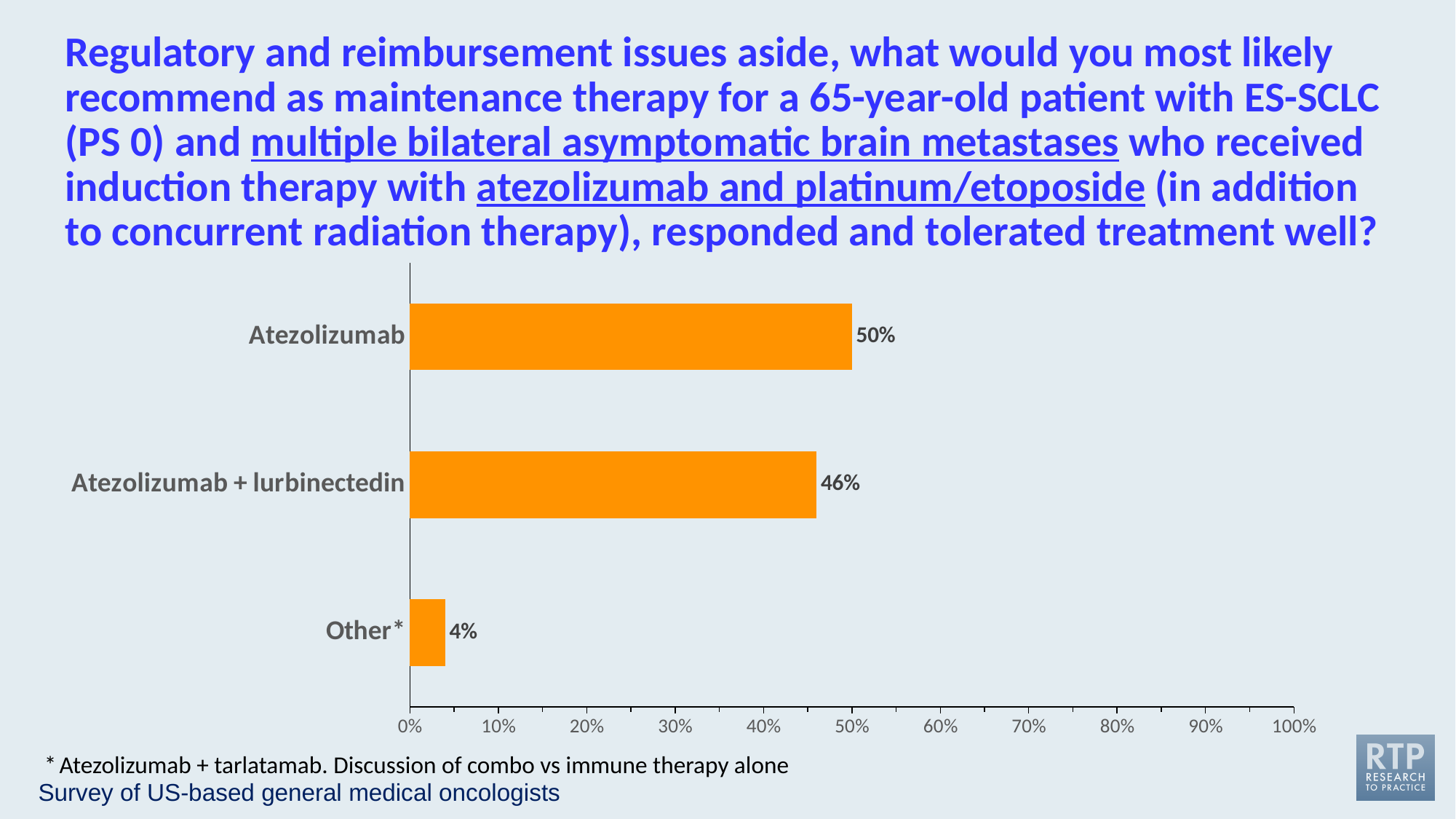
What is the difference in percentage points between Atezolizumab and Atezolizumab + lurbinectedin? 4 Which option received the lowest percentage of responses? Other* What percentage of respondents would recommend Atezolizumab alone as maintenance therapy? 50% According to the footnote, what does Other* refer to? Atezolizumab + tarlatamab What percentage of respondents chose Other*? 4% Which option received the highest percentage of responses? Atezolizumab What type of chart is shown on the slide? Bar chart Is the value for Atezolizumab + lurbinectedin greater or less than 40%? greater How many response options are shown in the chart? 3 What percentage of respondents chose Atezolizumab + lurbinectedin? 46% What is the difference in percentage points between Atezolizumab + lurbinectedin and Other*? 42 Which received a larger share of responses, Atezolizumab or Atezolizumab + lurbinectedin? Atezolizumab